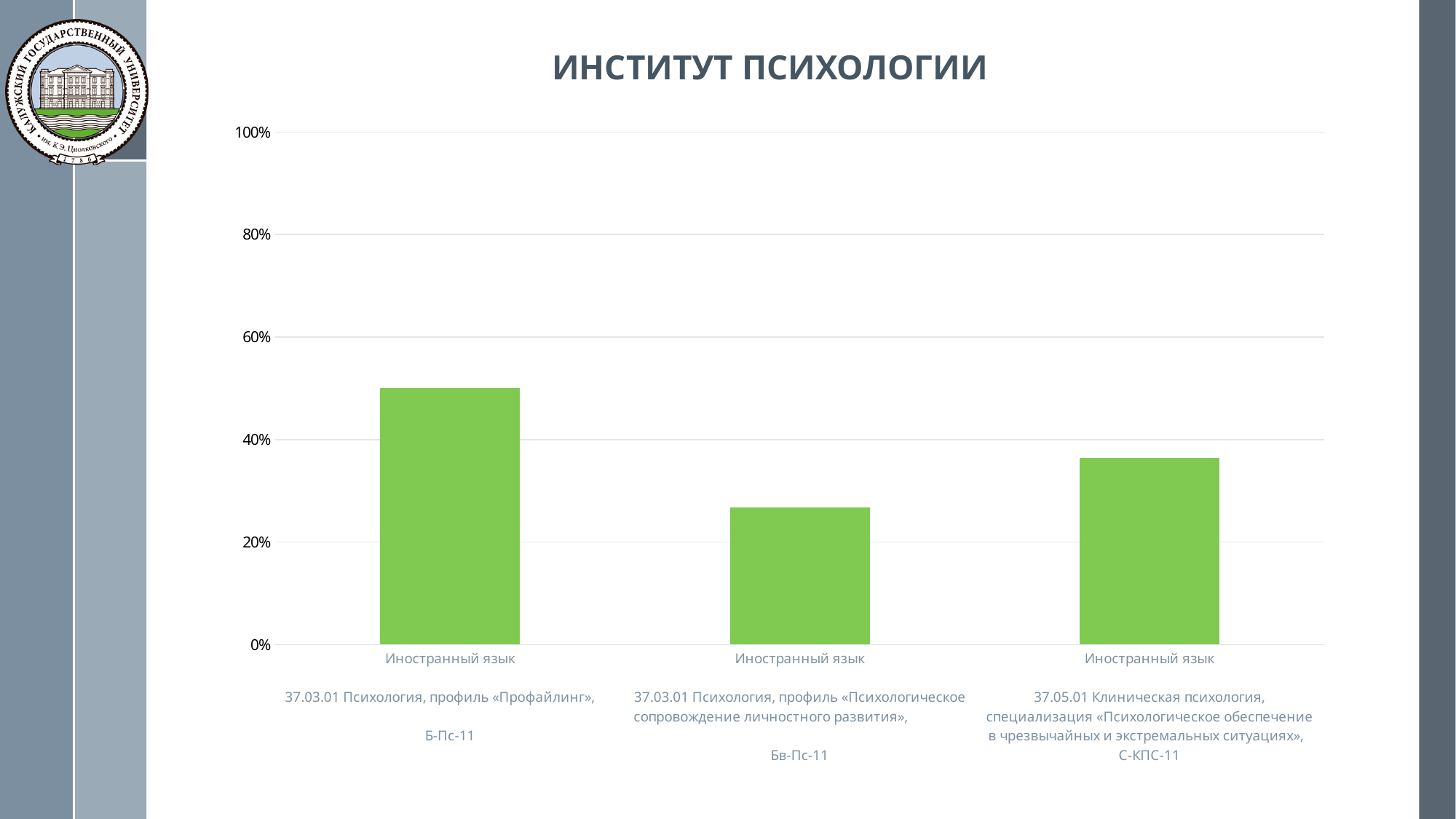
Is the value for Бв-Пс-11 greater or less than 40%? less Is the value for С-КПС-11 greater or less than 20%? greater Which group has the highest bar? Б-Пс-11 Is the value for Б-Пс-11 greater or less than 40%? greater Which is larger, the value for Б-Пс-11 or the value for С-КПС-11? Б-Пс-11 Which group has the lowest bar? Бв-Пс-11 What subject is named under each bar of the chart? Иностранный язык What is the title of the chart? ИНСТИТУТ ПСИХОЛОГИИ How many bars are plotted in the chart? 3 What kind of chart is shown on the slide? bar chart